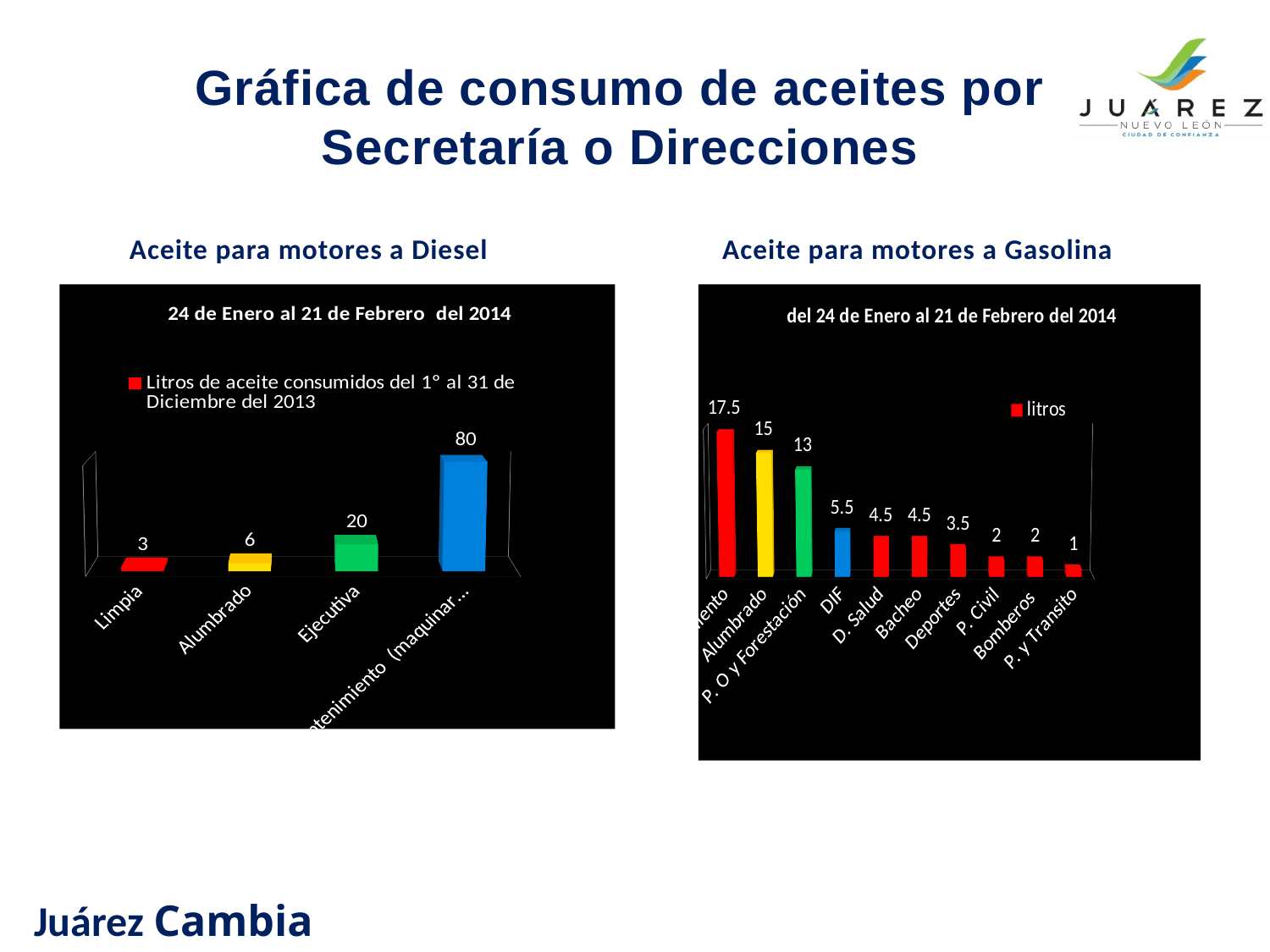
In the 'Aceite para motores a Diesel' chart, what is the value for Ejecutiva? 20 In the 'Aceite para motores a Diesel' chart, how many categories are shown? 4 What type of chart is the 'Aceite para motores a Gasolina' chart? Bar chart In the 'Aceite para motores a Gasolina' chart, how many categories are shown? 10 In the 'Aceite para motores a Diesel' chart, which category has the lowest value? Limpia In the 'Aceite para motores a Diesel' chart, what is the value for Limpia? 3 In the 'Aceite para motores a Gasolina' chart, what is the value for Alumbrado? 15 In the 'Aceite para motores a Diesel' chart, what is the largest value shown? 80 In the 'Aceite para motores a Gasolina' chart, which category has the lowest value? P. y Transito In the 'Aceite para motores a Gasolina' chart, what is the value for DIF? 5.5 In the 'Aceite para motores a Diesel' chart, what is the difference between Ejecutiva and Alumbrado? 14 In the 'Aceite para motores a Gasolina' chart, which is larger, P. O y Forestación or Deportes? P. O y Forestación